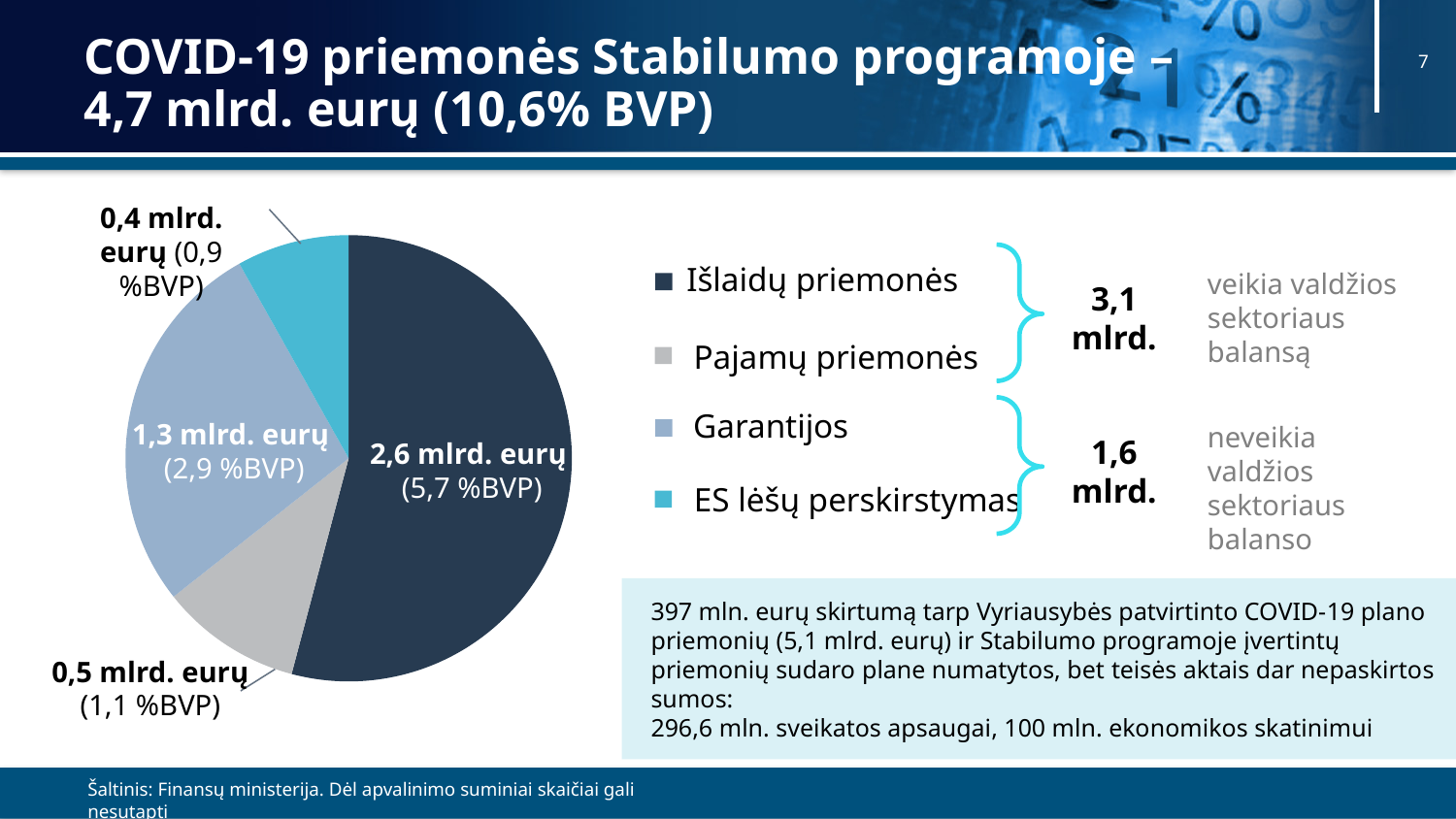
What is the difference in mlrd. eurų between Išlaidų priemonės and Garantijos? 1,3 mlrd. eurų Which category has the smallest slice in the pie chart? ES lėšų perskirstymas How many entries does the legend of the pie chart list? 4 What kind of chart is shown on the slide? Pie chart What value is shown for Pajamų priemonės in the pie chart? 0,5 mlrd. eurų (1,1 %BVP) What value is shown for Išlaidų priemonės in the pie chart? 2,6 mlrd. eurų (5,7 %BVP) What value is shown for Garantijos in the pie chart? 1,3 mlrd. eurų (2,9 %BVP) Which category has the largest slice in the pie chart? Išlaidų priemonės What value is shown for ES lėšų perskirstymas in the pie chart? 0,4 mlrd. eurų (0,9 %BVP) How many slices does the pie chart have? 4 Which is larger in the pie chart, Garantijos or Pajamų priemonės? Garantijos Which colour represents ES lėšų perskirstymas in the pie chart? Cyan (light turquoise)